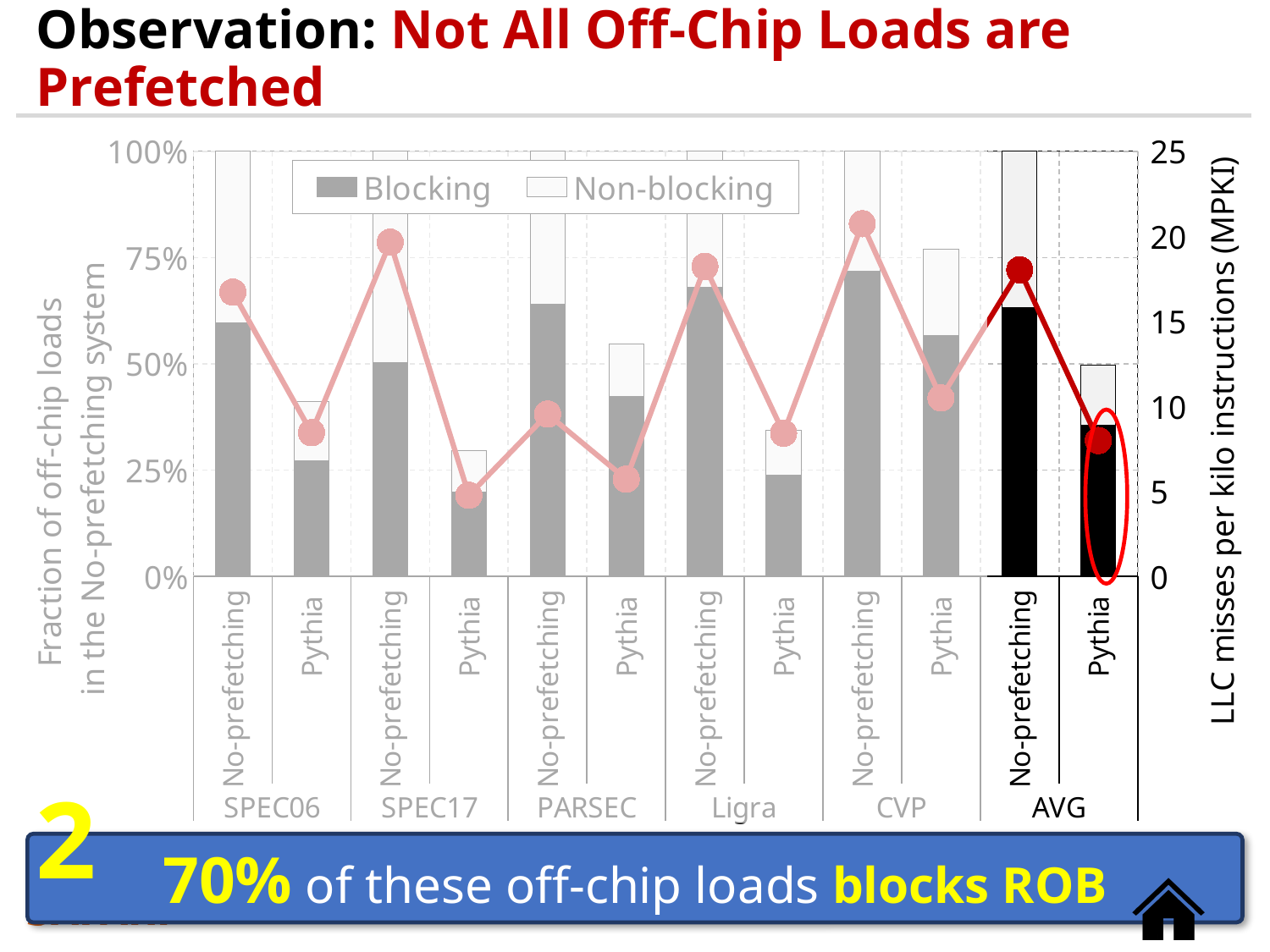
Is the LLC MPKI value for Pythia in AVG greater or less than 10? less Is the Blocking value for No-prefetching in SPEC06 greater or less than 50%? greater Is the Blocking value for Pythia in SPEC17 greater or less than 25%? less How many bars are plotted in total? 12 Which bar has the lowest Blocking fraction? Pythia in SPEC17 What are the two series named in the legend? Blocking and Non-blocking How many benchmark groups are shown along the x axis? 6 What is the total height of the No-prefetching stacked bar for SPEC06? 100% How many series does the legend list? 2 What kind of chart is shown on the slide? Stacked bar chart with a line overlay